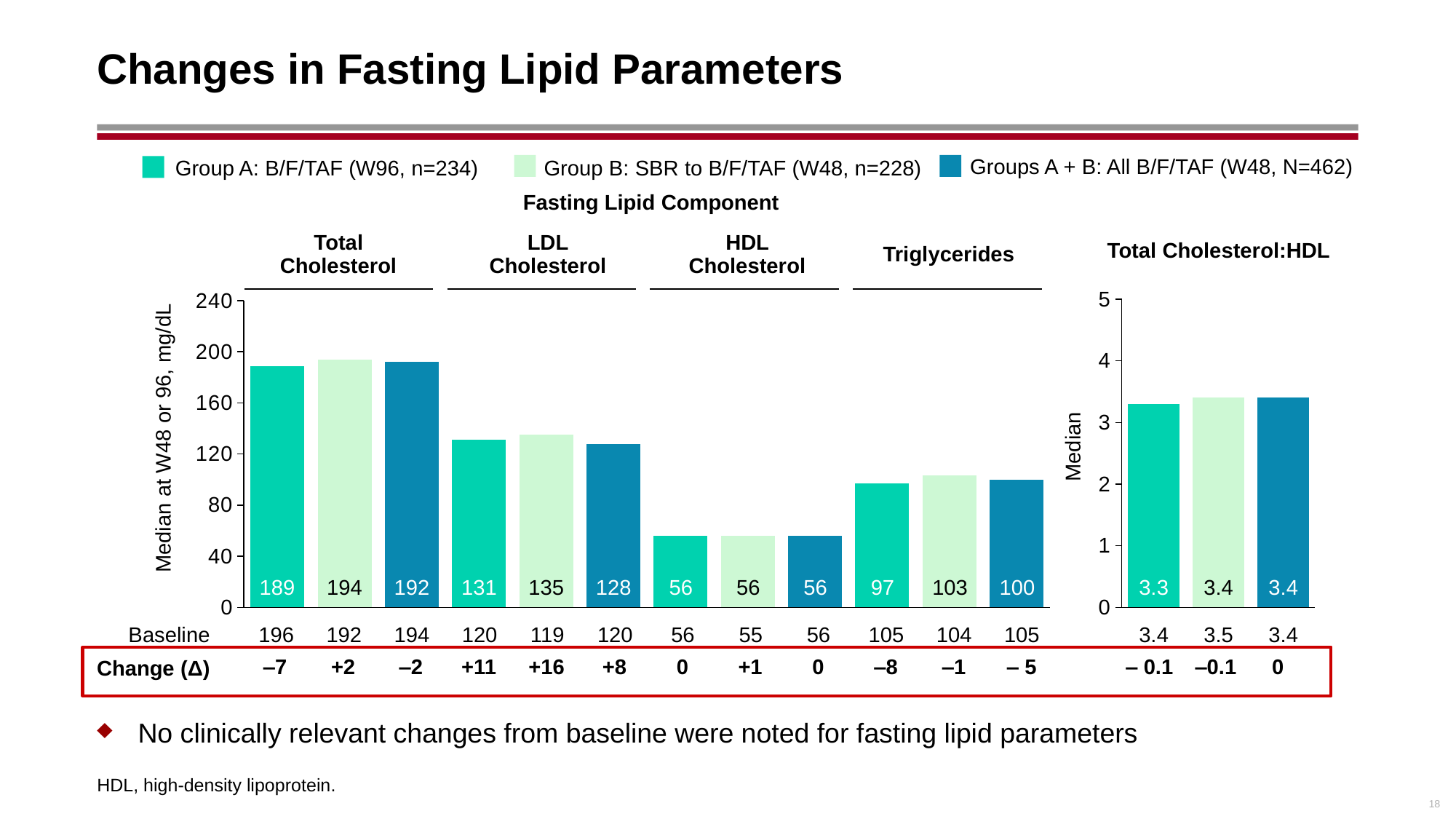
In the Fasting Lipid Component chart, what is the median Total Cholesterol value for Group A: B/F/TAF (W96, n=234)? 189 In the Fasting Lipid Component chart, is the median HDL Cholesterol for Group A greater or less than 80? less In the Fasting Lipid Component chart, which is larger: the median Triglycerides for Group A or for Group B? Group B In the Fasting Lipid Component chart, what is the difference between the median LDL Cholesterol for Group B and for Groups A + B? 7 How many series does the legend list? 3 In the Total Cholesterol:HDL chart, what is the median value for Group A: B/F/TAF (W96, n=234)? 3.3 In the Fasting Lipid Component chart, what is the median LDL Cholesterol value for Group B: SBR to B/F/TAF (W48, n=228)? 135 What kind of chart is the Fasting Lipid Component chart? Bar chart In the Fasting Lipid Component chart, what is the median Triglycerides value for Groups A + B: All B/F/TAF (W48, N=462)? 100 What is the y-axis label of the Fasting Lipid Component chart? Median at W48 or 96, mg/dL In the Fasting Lipid Component chart, which group has the highest median Total Cholesterol? Group B: SBR to B/F/TAF (W48, n=228) How many fasting lipid components are shown on the left chart (Fasting Lipid Component)? 4